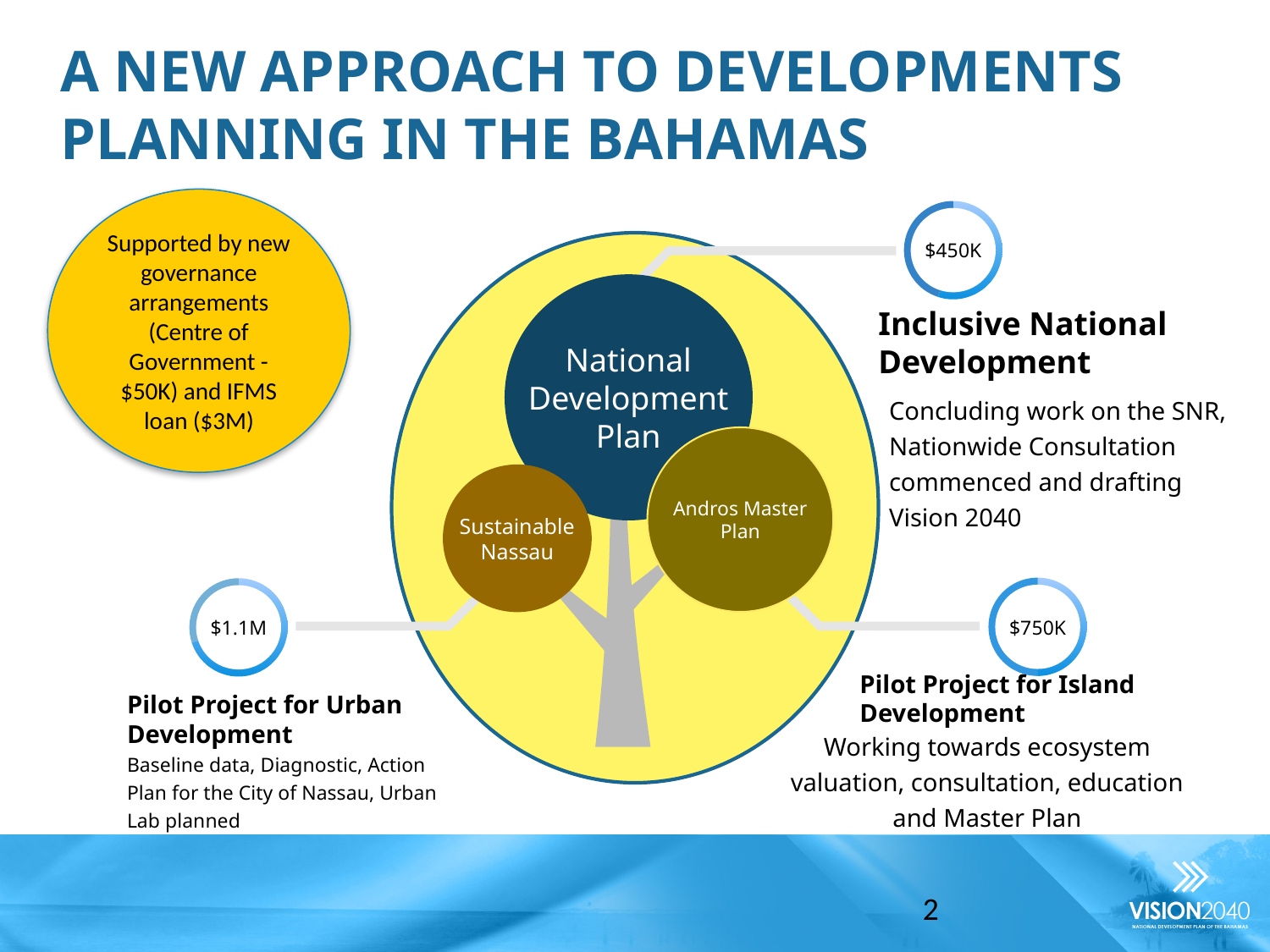
What is the difference between the value for Pilot Project for Urban Development and the value for Pilot Project for Island Development? $350K What is the difference between the value for Pilot Project for Island Development and the value for Inclusive National Development? $300K What is the label in the large dark blue circle at the centre of the diagram? National Development Plan Which of the three initiatives has the lowest value shown in its ring indicator? Inclusive National Development How many ring indicators with dollar values are shown on the slide? 3 What value is shown in the ring indicator next to Pilot Project for Urban Development? $1.1M What value is shown in the ring indicator next to Pilot Project for Island Development? $750K Which is larger, the value for Pilot Project for Island Development or the value for Inclusive National Development? Pilot Project for Island Development What value is shown in the ring indicator next to Inclusive National Development? $450K What are the labels of the two smaller circles below the National Development Plan circle? Sustainable Nassau and Andros Master Plan Which of the three initiatives has the highest value shown in its ring indicator? Pilot Project for Urban Development